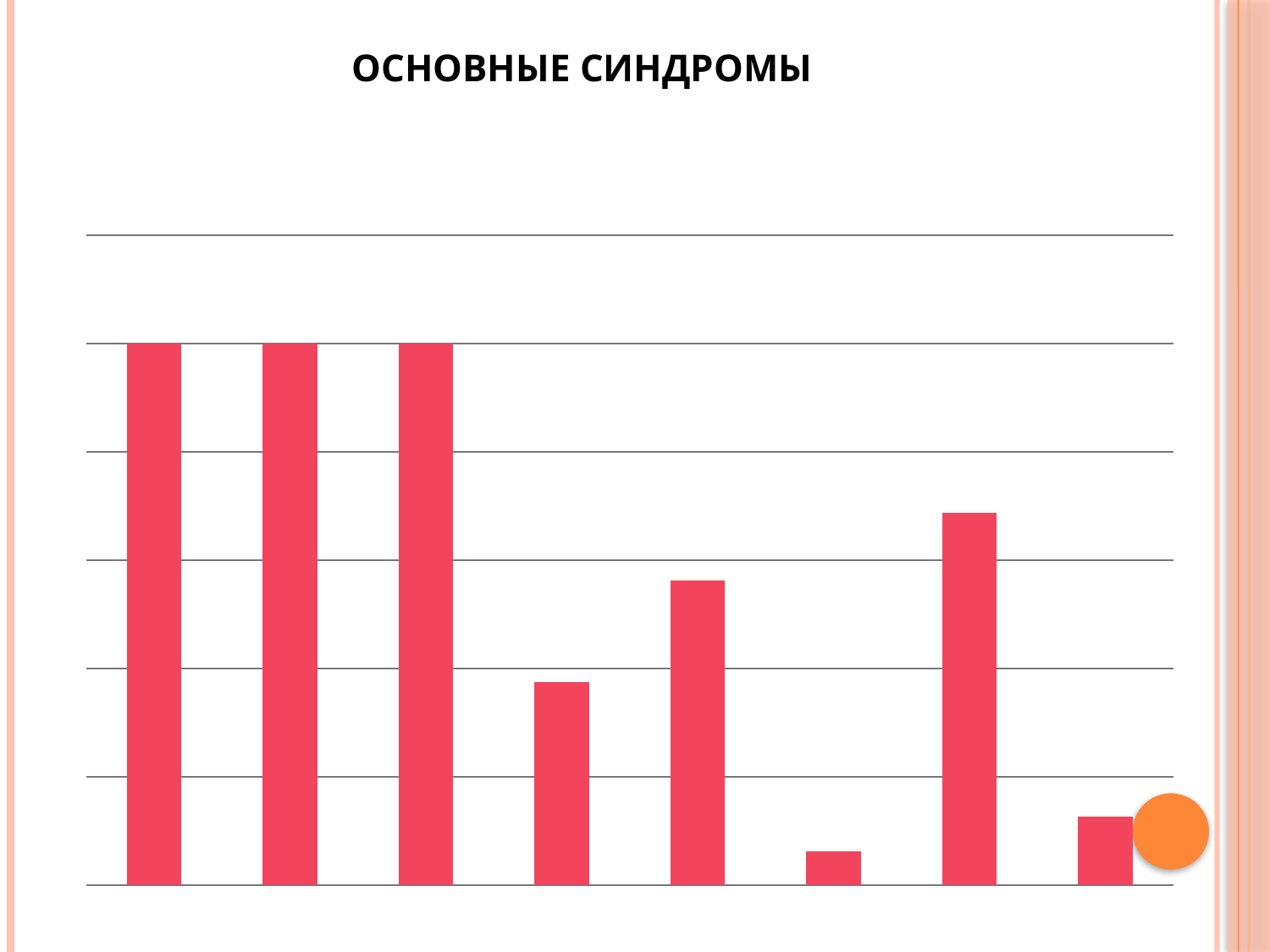
Which is taller, the first bar from the left or the fourth bar from the left? the first bar Do the first three bars from the left have the same height? yes Which is taller, the seventh bar from the left or the eighth bar from the left? the seventh bar What kind of chart is shown on the slide? bar chart What is the title of the chart on the slide? ОСНОВНЫЕ СИНДРОМЫ Which bar, counted from the left, is the lowest in the chart? the sixth bar How many bars are plotted in the chart? 8 What colour are the bars in the chart? red